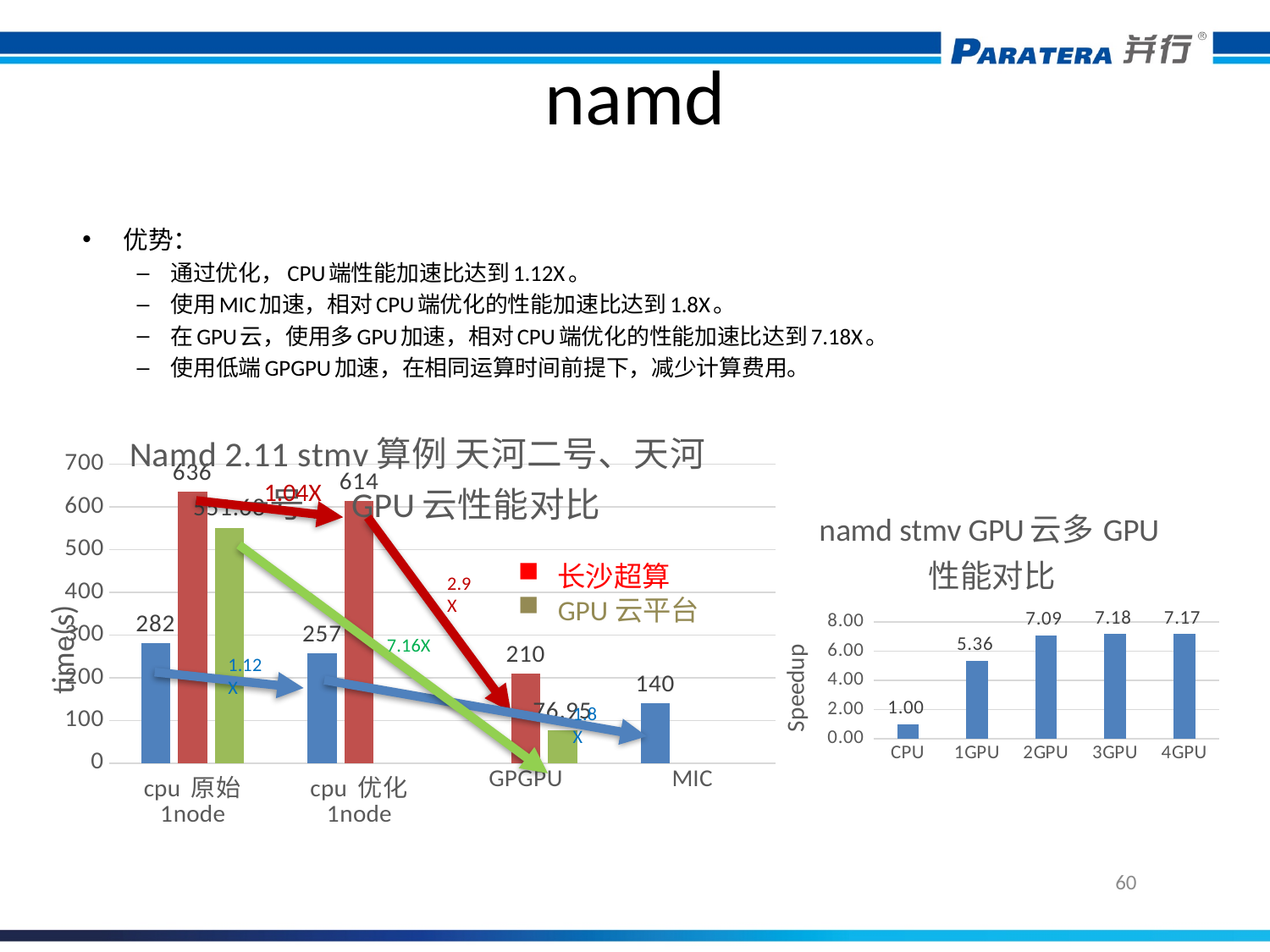
In the left chart, what is the 长沙超算 value for cpu 原始 1node? 636 What kind of chart is the right chart (namd stmv GPU 云多 GPU 性能对比)? bar chart In the left chart, how many series does the legend list? 2 In the right chart (namd stmv GPU 云多 GPU 性能对比), which category has the lowest speedup? CPU In the right chart (namd stmv GPU 云多 GPU 性能对比), what is the speedup for 1GPU? 5.36 In the right chart (namd stmv GPU 云多 GPU 性能对比), what is the speedup for 2GPU? 7.09 In the left chart, what is the difference between the blue bar values for cpu 原始 1node (282) and cpu 优化 1node (257)? 25 In the right chart (namd stmv GPU 云多 GPU 性能对比), what is the difference between the speedup for 1GPU and for CPU? 4.36 In the left chart, what is the time value for MIC? 140 In the right chart (namd stmv GPU 云多 GPU 性能对比), how many categories are shown on the x axis? 5 In the left chart, is the value for MIC greater or less than 100? greater In the left chart, what is the 长沙超算 value for GPGPU? 210